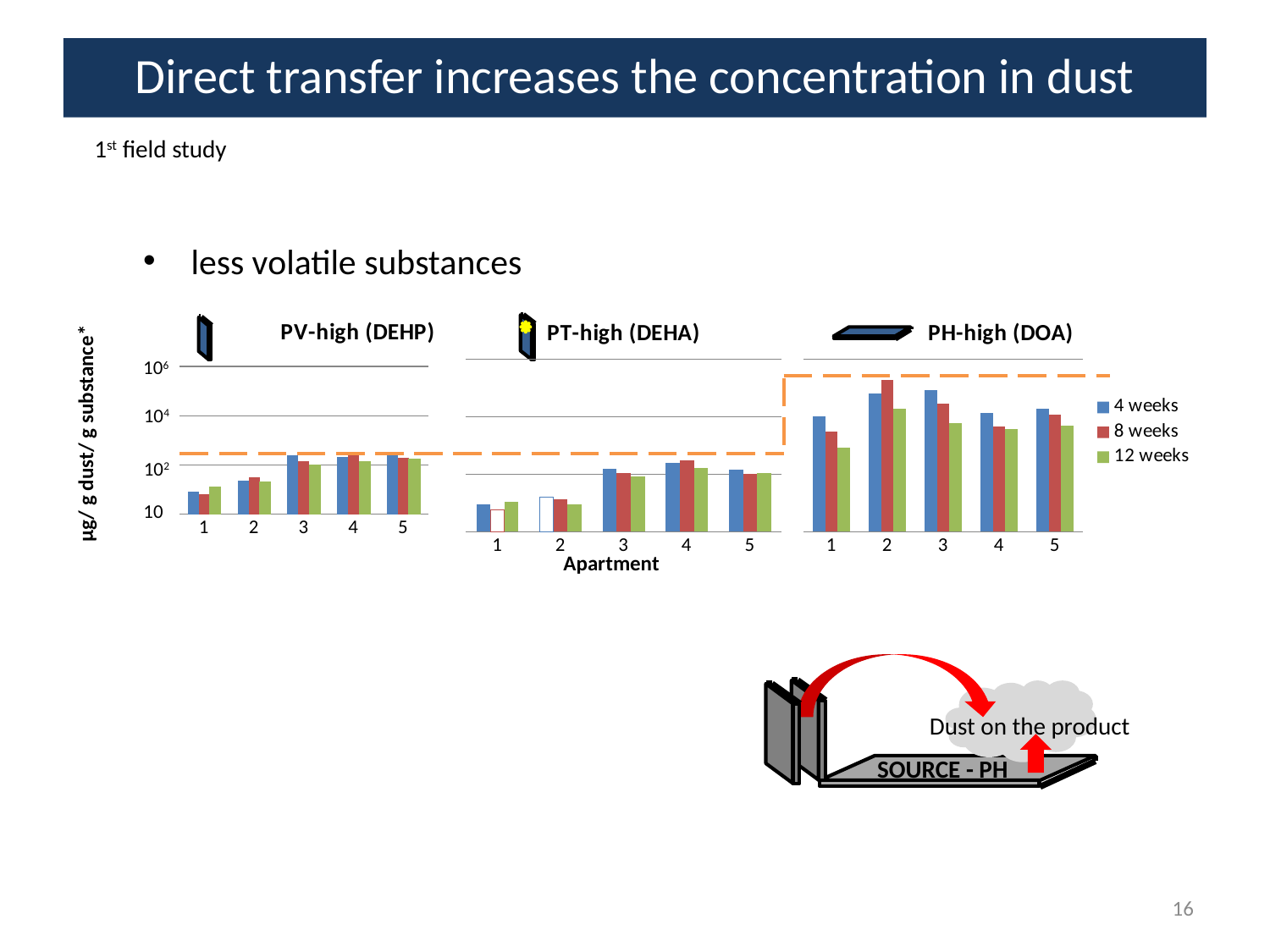
How many series does the legend list for the charts? 3 What are the three legend entries for the charts? 4 weeks, 8 weeks, 12 weeks In the PV-high (DEHP) chart, for apartment 2, which is larger: the 4 weeks value or the 8 weeks value? 8 weeks What kind of chart is the PH-high (DOA) chart? bar chart In the PH-high (DOA) chart, for apartment 1, which is larger: the 4 weeks value or the 12 weeks value? 4 weeks What is the label of the x axis under the PT-high (DEHA) chart? Apartment How many apartments are shown on the x axis of the PV-high (DEHP) chart? 5 In the PV-high (DEHP) chart, is the 4 weeks value for apartment 1 greater or less than 10^2? less In the PT-high (DEHA) chart, is the 12 weeks value for apartment 1 greater or less than 10^2? less In the PH-high (DOA) chart, is the 12 weeks value for apartment 5 greater or less than 10^2? greater In the PH-high (DOA) chart, which apartment has the highest 8 weeks value? 2